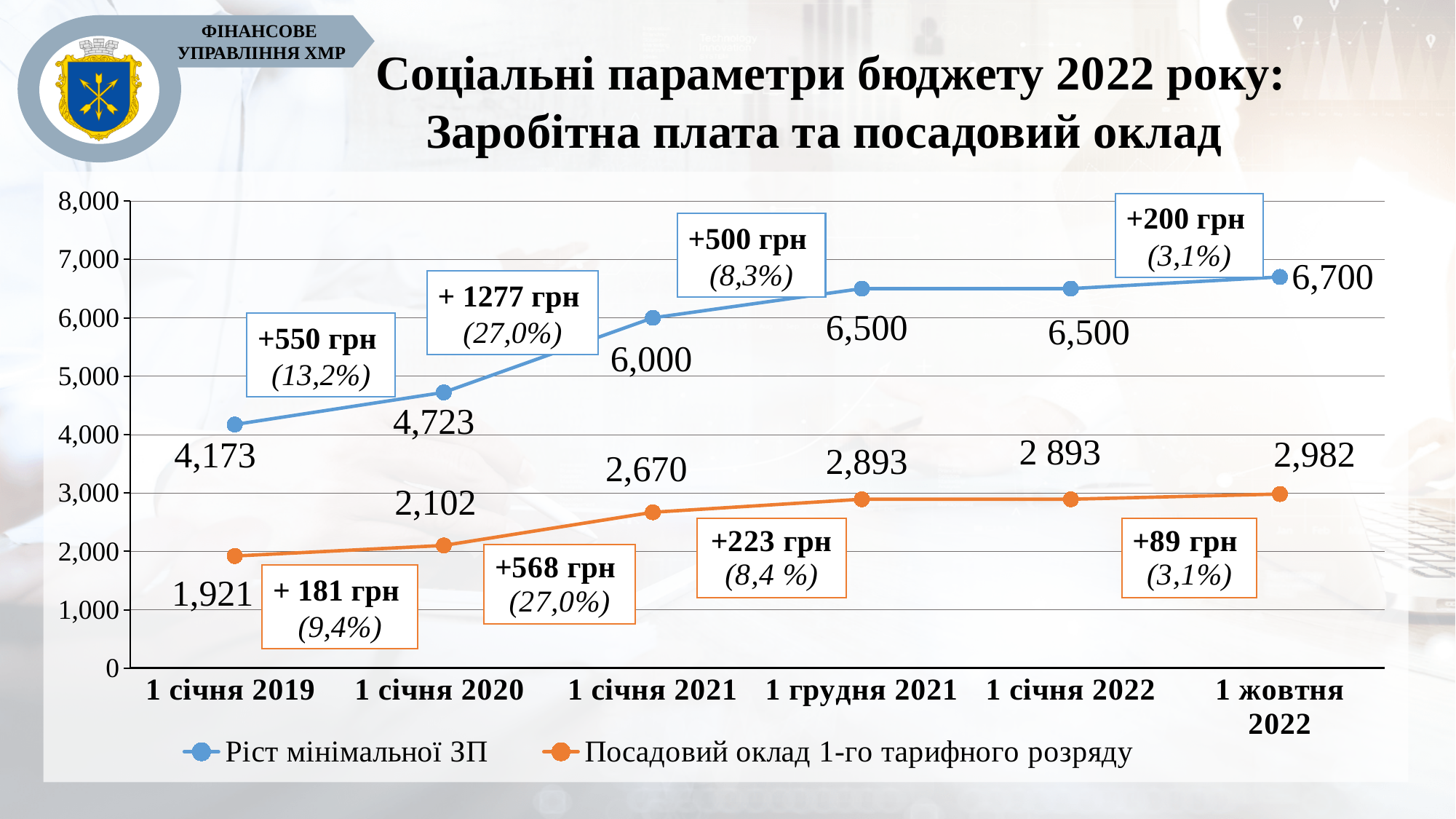
What is the difference between "Ріст мінімальної ЗП" and "Посадовий оклад 1-го тарифного розряду" on 1 січня 2021? 3,330 Which is larger on 1 грудня 2021: "Ріст мінімальної ЗП" or "Посадовий оклад 1-го тарифного розряду"? Ріст мінімальної ЗП What type of chart is shown on the slide? line chart On which date is "Посадовий оклад 1-го тарифного розряду" highest? 1 жовтня 2022 What is the value of "Посадовий оклад 1-го тарифного розряду" on 1 січня 2021? 2,670 On which date is "Ріст мінімальної ЗП" lowest? 1 січня 2019 How many series does the legend list? 2 What is the value of "Ріст мінімальної ЗП" on 1 жовтня 2022? 6,700 What is the value of "Посадовий оклад 1-го тарифного розряду" on 1 січня 2020? 2,102 Does "Ріст мінімальної ЗП" rise or fall from 1 січня 2019 to 1 січня 2021? rise What is the value of "Ріст мінімальної ЗП" on 1 січня 2019? 4,173 How many dates are shown on the x axis? 6